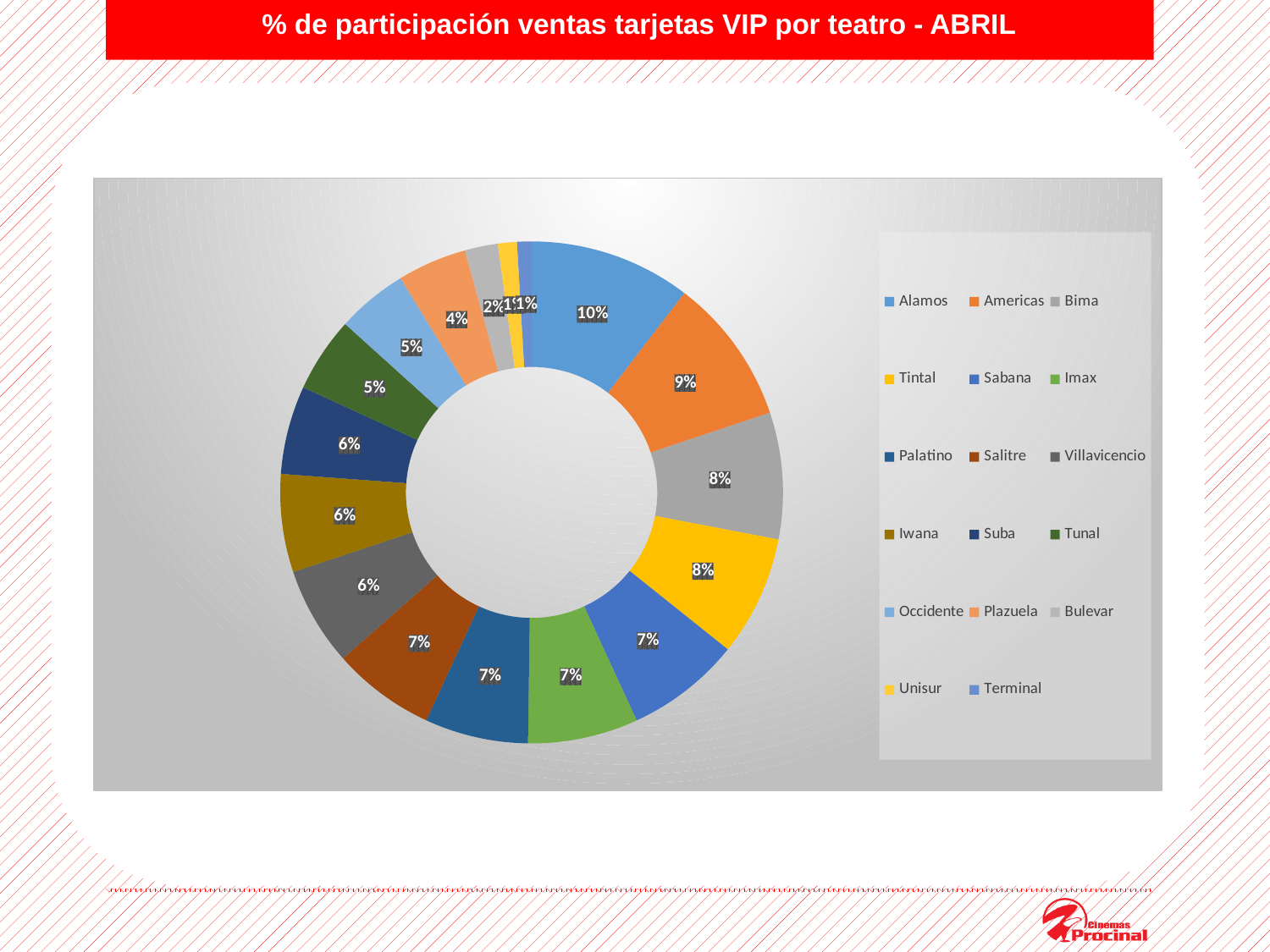
Which has a larger share, Americas or Tunal? Americas What kind of chart is shown on the slide? Doughnut (pie) chart Which theatre has the largest share in the chart? Alamos What is the value shown for Americas? 9% What is the title of the chart? % de participación ventas tarjetas VIP por teatro - ABRIL What share does Bulevar have? 2% How many theatres are listed in the legend? 17 What percentage is shown for Bima? 8% What share does Alamos have in the chart? 10% What is the combined share of Alamos and Americas? 19% What is the difference between the shares of Alamos and Plazuela? 6 percentage points What is the value for Plazuela? 4%